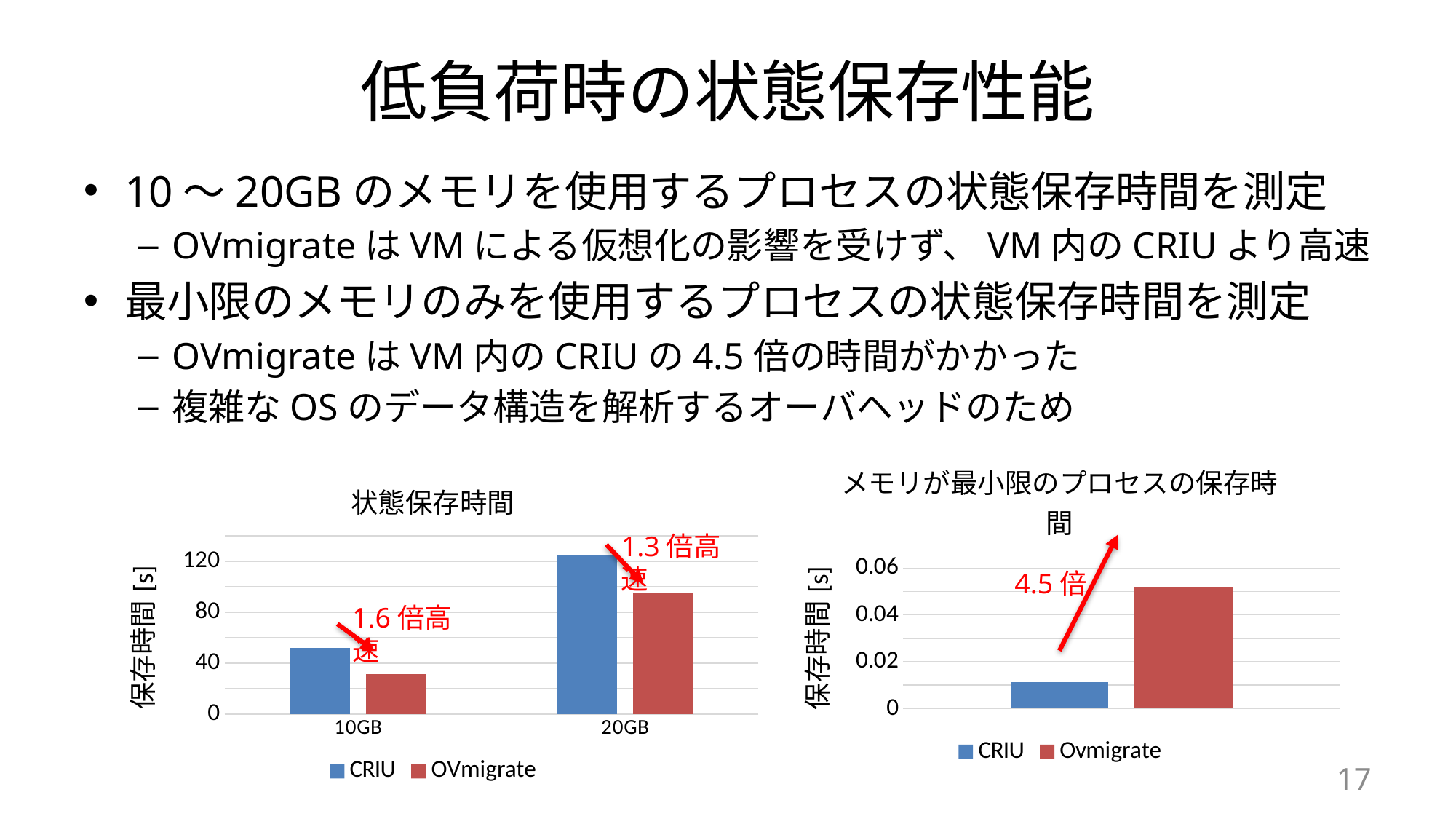
In the left chart titled 状態保存時間, does the CRIU value rise or fall from 10GB to 20GB? rise In the right chart titled メモリが最小限のプロセスの保存時間, what is the y-axis label? 保存時間 [s] What kind of chart is the left chart titled 状態保存時間? bar chart In the left chart titled 状態保存時間, how many categories are shown on the x axis? 2 In the right chart titled メモリが最小限のプロセスの保存時間, is the value for CRIU greater or less than 0.02? less In the left chart titled 状態保存時間, which is larger for 20GB, CRIU or OVmigrate? CRIU In the right chart titled メモリが最小限のプロセスの保存時間, is the value for Ovmigrate greater or less than 0.04? greater In the left chart titled 状態保存時間, is the value for OVmigrate at 10GB greater or less than 40? less In the left chart titled 状態保存時間, what speedup annotation is shown for the 10GB category? 1.6 倍高速 In the right chart titled メモリが最小限のプロセスの保存時間, which series has the higher value, CRIU or Ovmigrate? Ovmigrate In the left chart titled 状態保存時間, how many series does the legend list? 2